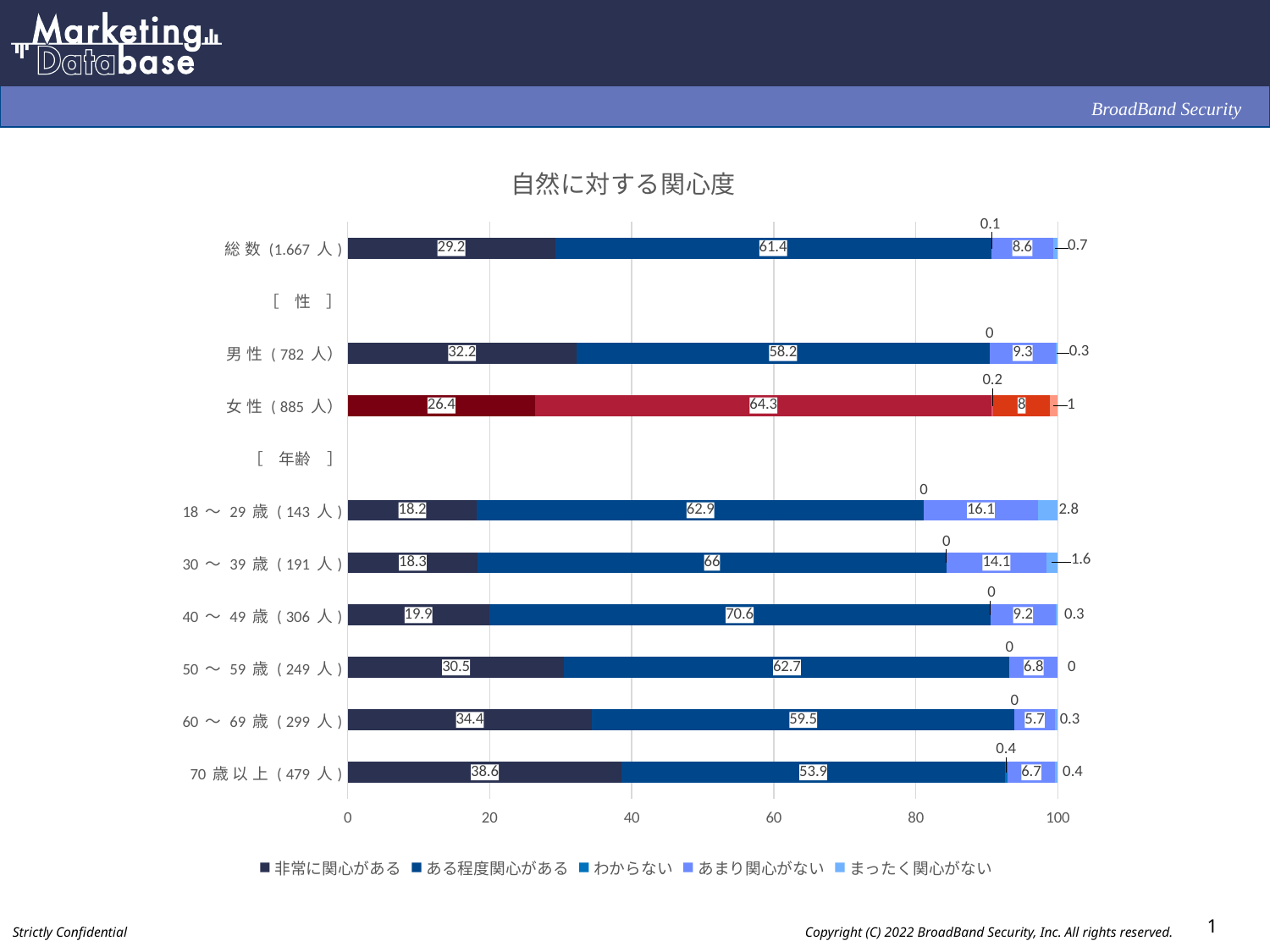
What is the title of the chart? 自然に対する関心度 What is the value of ある程度関心がある for 女性 (885 人)? 64.3 What is the value of まったく関心がない for 30 ～ 39 歳 (191 人)? 1.6 Which age group has the lowest value for あまり関心がない? 60 ～ 69 歳 (299 人) Which is larger, the ある程度関心がある value for 40 ～ 49 歳 (306 人) or for 50 ～ 59 歳 (249 人)? 40 ～ 49 歳 (306 人) Which age group has the highest value for 非常に関心がある? 70 歳以上 (479 人) What is the value of あまり関心がない for 18 ～ 29 歳 (143 人)? 16.1 Which age group has the highest value for ある程度関心がある? 40 ～ 49 歳 (306 人) How many series does the legend list? 5 What type of chart is shown on the slide? Stacked bar chart What is the value of 非常に関心がある for 総数 (1,667 人)? 29.2 What is the difference between the 非常に関心がある values for 男性 (782 人) and 女性 (885 人)? 5.8